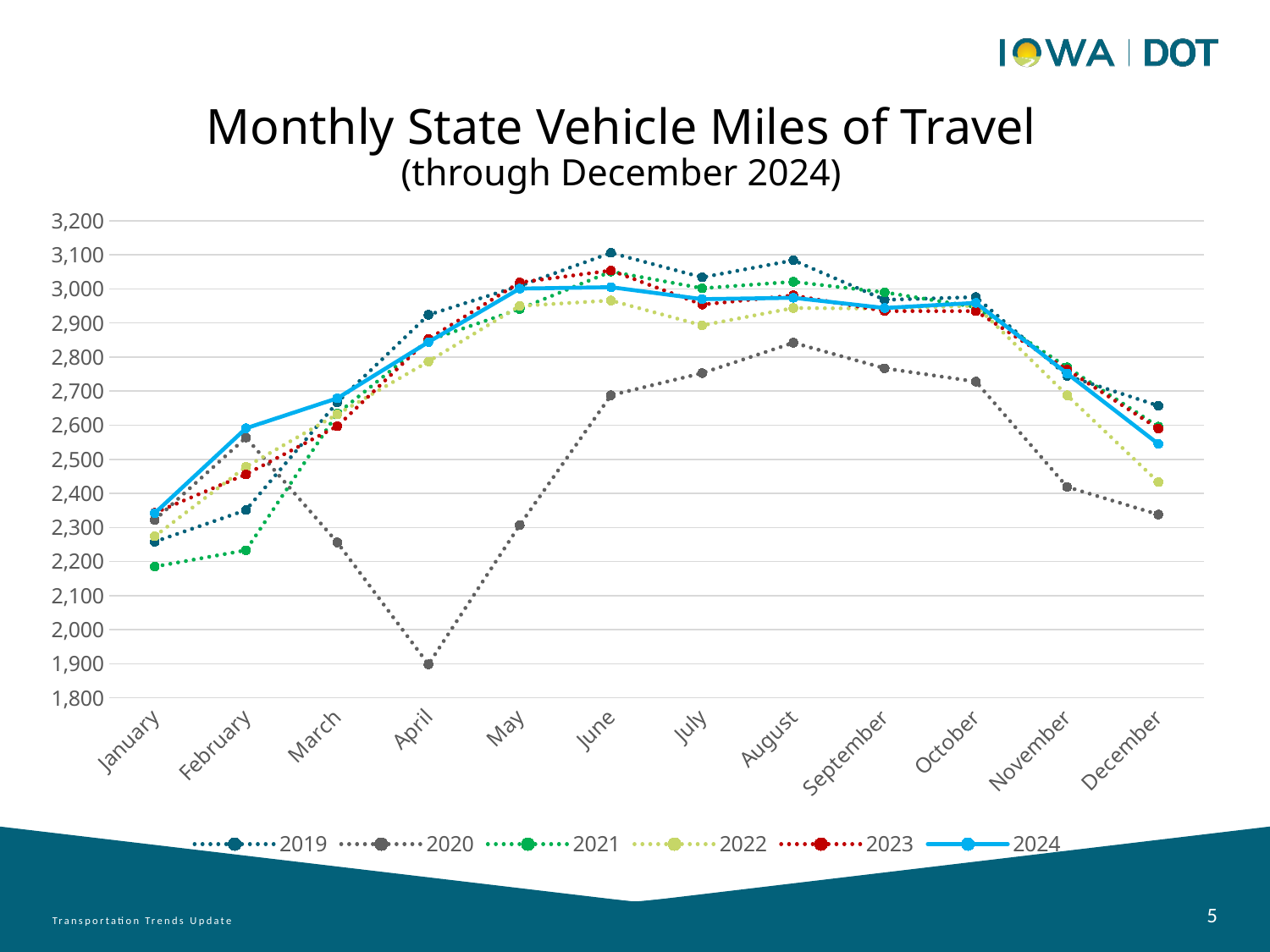
Is the 2019 value for June greater or less than 3,000? greater What kind of chart is shown on the slide? line chart Is the 2020 value for April greater or less than 2,000? less Is the 2024 value for January greater or less than 2,400? less In which month does the 2020 series reach its lowest value? April How many months are plotted along the x axis? 12 How many series does the legend list? 6 Which series has the larger value in April, 2019 or 2020? 2019 In which month does the 2019 series reach its highest value? June Which series is drawn as a solid line rather than a dotted line? 2024 In which month does the 2024 series have its lowest value? January Does the 2020 series rise or fall from January to April? fall